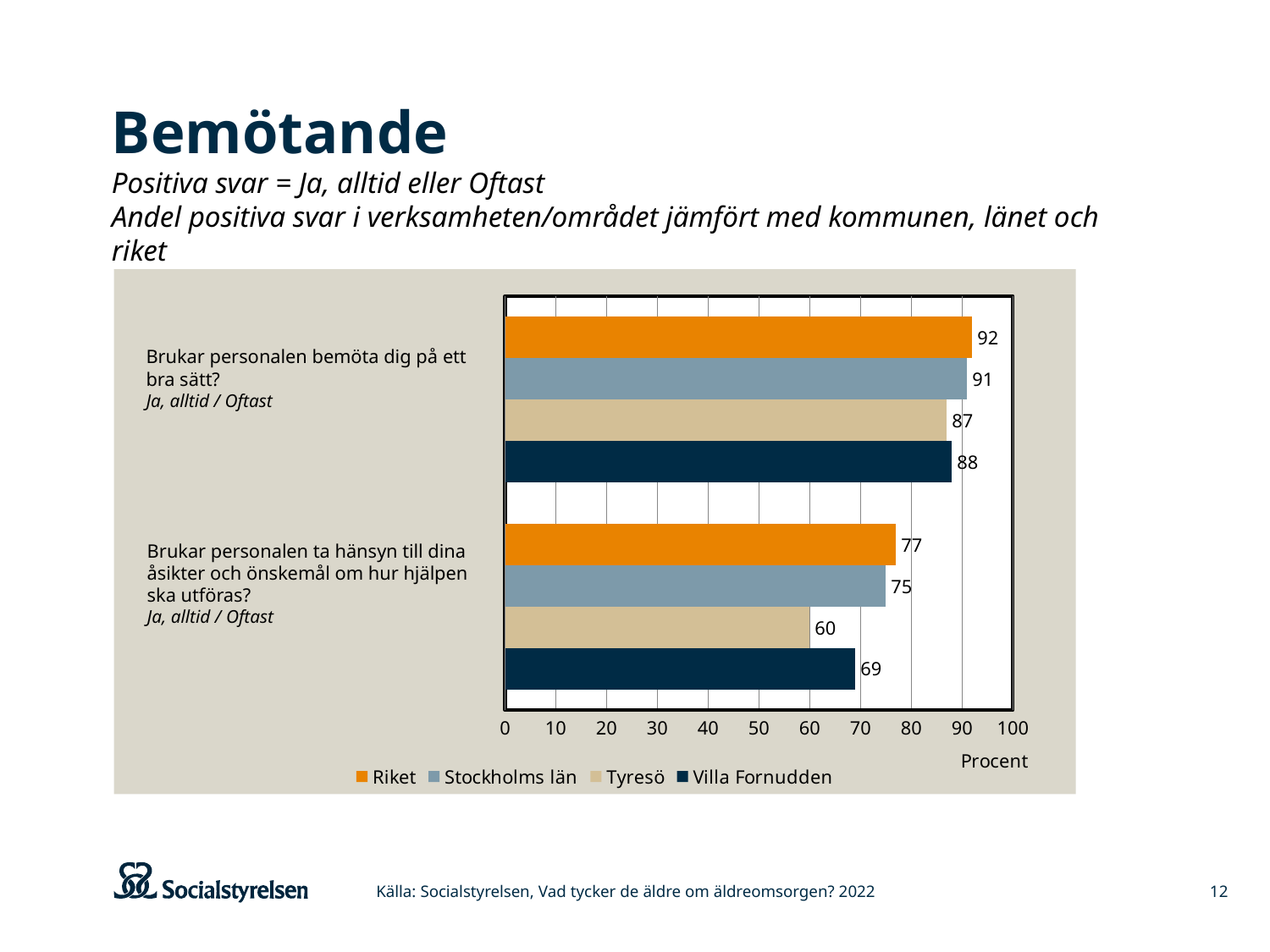
Which series has the highest value for the question 'Brukar personalen ta hänsyn till dina åsikter och önskemål om hur hjälpen ska utföras?' Riket What is the value for Riket for the question 'Brukar personalen bemöta dig på ett bra sätt?' 92 How many questions (categories) are shown on the chart? 2 What is the label on the horizontal axis of the chart? Procent How many series does the legend list? 4 What is the value for Villa Fornudden for the question 'Brukar personalen bemöta dig på ett bra sätt?' 88 What is the value for Tyresö for the question 'Brukar personalen ta hänsyn till dina åsikter och önskemål om hur hjälpen ska utföras?' 60 What is the value for Stockholms län for the question 'Brukar personalen ta hänsyn till dina åsikter och önskemål om hur hjälpen ska utföras?' 75 What kind of chart is shown on the slide? Bar chart What is the difference between the Riket and Tyresö values for the question 'Brukar personalen ta hänsyn till dina åsikter och önskemål om hur hjälpen ska utföras?' 17 Which series has the lowest value for the question 'Brukar personalen bemöta dig på ett bra sätt?' Tyresö Which is larger for the question 'Brukar personalen bemöta dig på ett bra sätt?': the value for Villa Fornudden or the value for Tyresö? Villa Fornudden